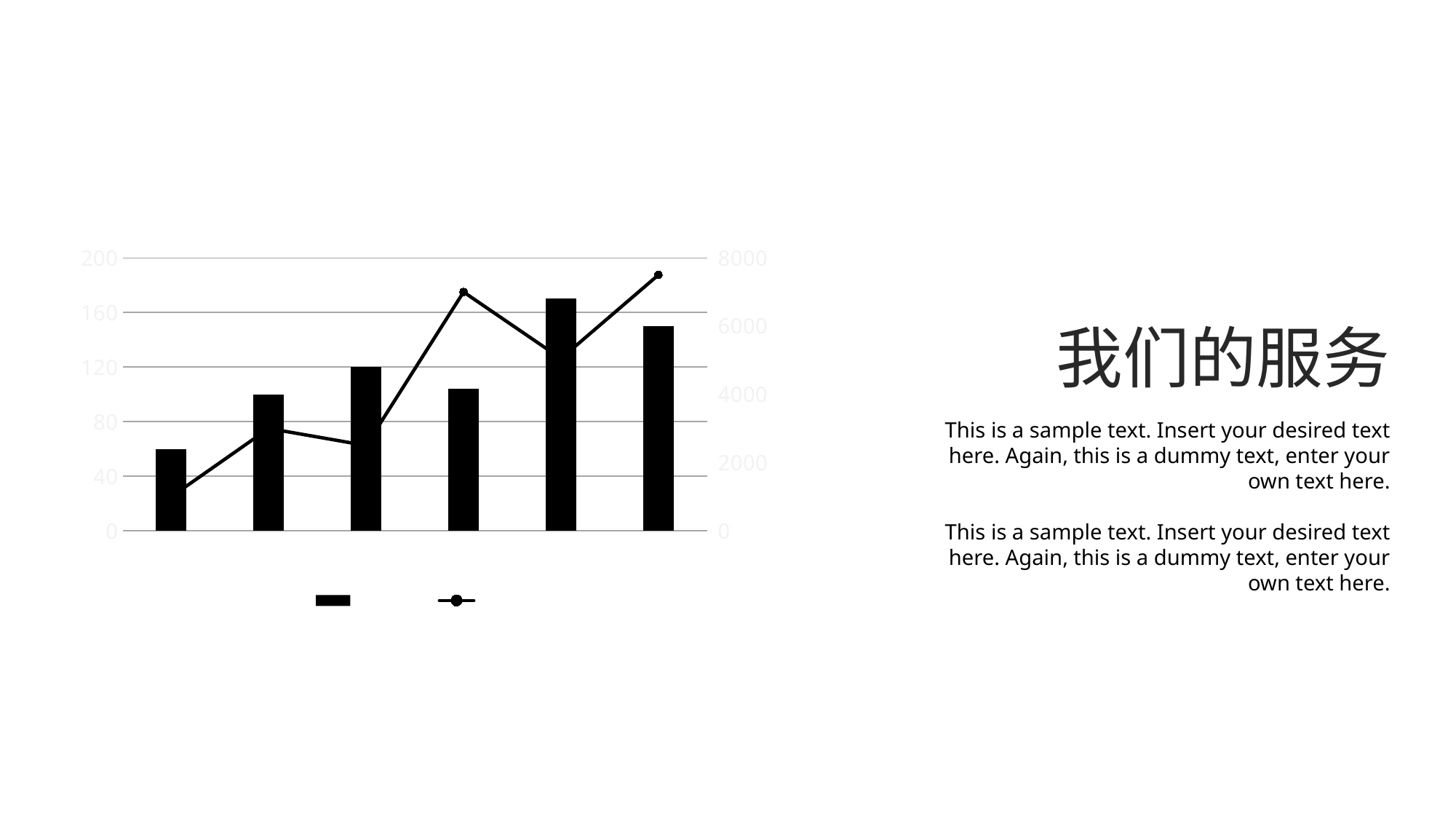
Is the rightmost point of the line greater or less than 6000 on the right axis? greater Is the leftmost point of the line greater or less than 2000 on the right axis? less How many series does the legend list? 2 What is the highest value shown on the right vertical axis? 8000 Is the value of the leftmost bar greater or less than 80 on the left axis? less Is the leftmost bar taller or shorter than the rightmost bar? shorter How many bars are plotted in the chart? 6 What kind of chart is shown on the slide? A combination bar and line chart Which bar is the tallest, counting from the left? The fifth bar Which bar is the shortest, counting from the left? The first (leftmost) bar What is the highest value shown on the left vertical axis? 200